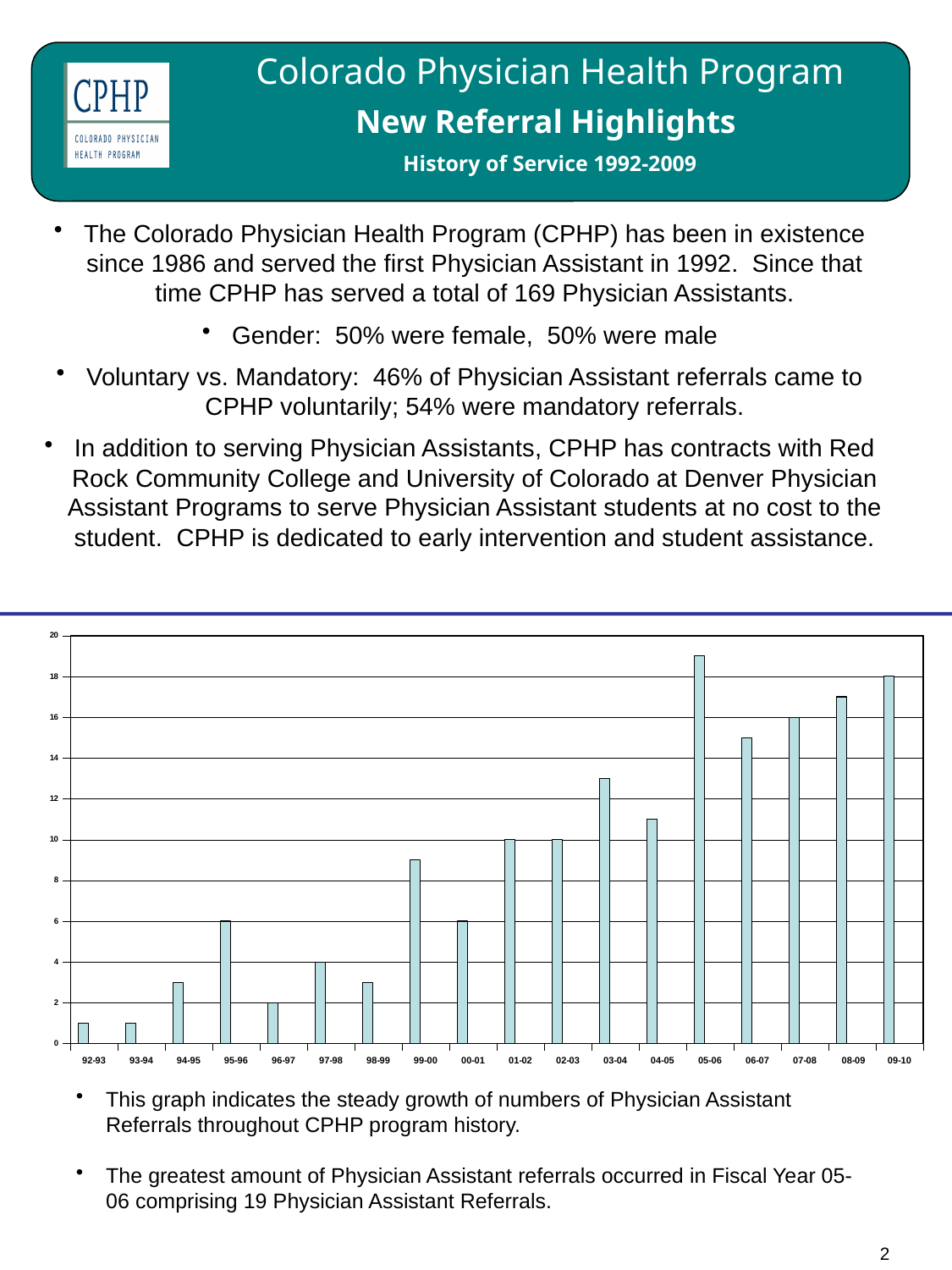
Which fiscal year has the highest number of referrals in the chart? 05-06 What is the value for fiscal year 07-08 in the chart? 16 Is the value for 94-95 greater or less than 4? less What is the value for fiscal year 95-96 in the chart? 6 How many fiscal-year categories are shown on the x axis of the chart? 18 What is the value for fiscal year 09-10 in the chart? 18 What kind of chart is shown on the slide? bar chart What is the value for fiscal year 05-06 in the chart? 19 What is the difference between the values for 09-10 and 07-08? 2 Which is larger, the value for 99-00 or the value for 00-01? 99-00 Is the value for 03-04 greater or less than 10? greater Do the values generally rise or fall from 92-93 to 09-10 along the x axis? rise